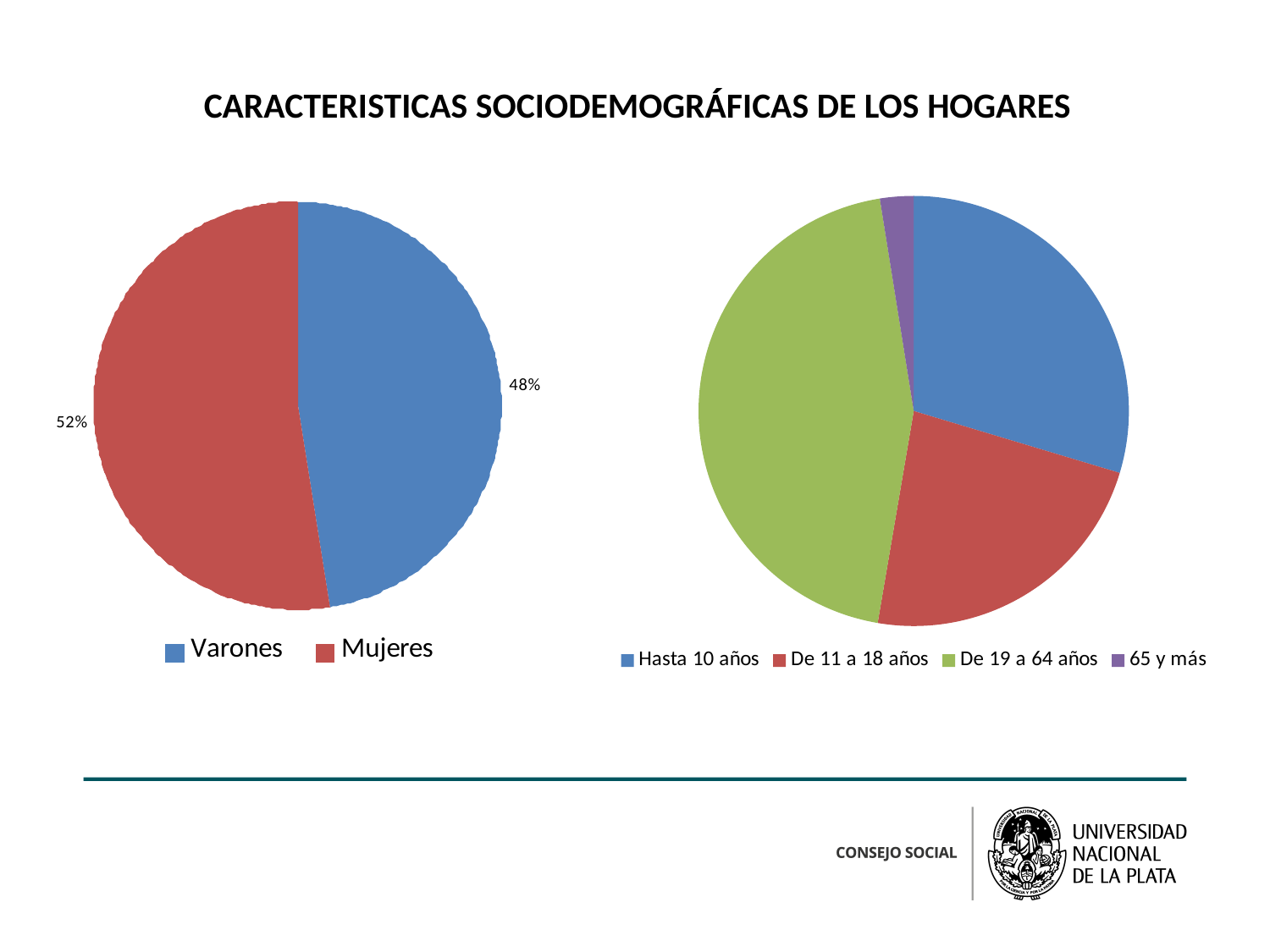
What kind of chart is the chart on the left of the slide? Pie chart In the pie chart on the left, which category has the larger share? Mujeres In the pie chart on the right, which slice is larger: Hasta 10 años or De 11 a 18 años? Hasta 10 años In the pie chart on the right, which age group has the largest slice? De 19 a 64 años In the pie chart on the right, which age group has the smallest slice? 65 y más In the pie chart on the left, what percentage is shown for Varones? 48% How many slices does the pie chart on the left have? 2 In the pie chart on the left, what percentage is shown for Mujeres? 52% In the pie chart on the right, what colour represents De 19 a 64 años? Green In the pie chart on the left, what is the difference in percentage points between Mujeres and Varones? 4% How many categories does the pie chart on the right show? 4 What is the title shown at the top of the slide above the two pie charts? CARACTERISTICAS SOCIODEMOGRÁFICAS DE LOS HOGARES